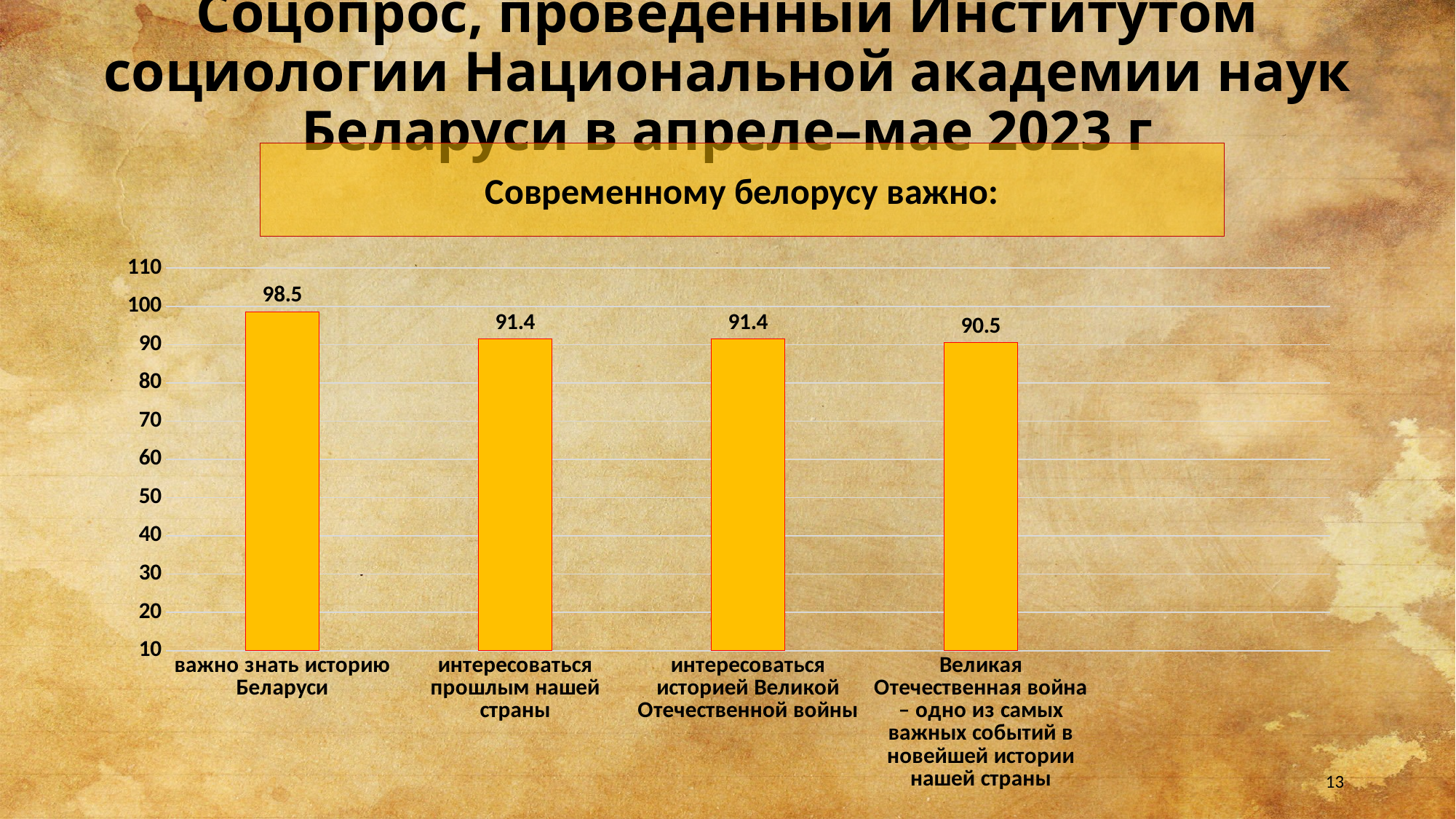
What is the difference between the values for "интересоваться историей Великой Отечественной войны" and "Великая Отечественная война – одно из самых важных событий в новейшей истории нашей страны"? 0.9 Which category has the lowest value? Великая Отечественная война – одно из самых важных событий в новейшей истории нашей страны What is the value for the category "Великая Отечественная война – одно из самых важных событий в новейшей истории нашей страны"? 90.5 What is the value for "интересоваться историей Великой Отечественной войны"? 91.4 What is the value for "важно знать историю Беларуси"? 98.5 Which category has the highest value? важно знать историю Беларуси Which is larger: the value for "важно знать историю Беларуси" or the value for "Великая Отечественная война – одно из самых важных событий в новейшей истории нашей страны"? важно знать историю Беларуси What is the heading shown in the box above the chart? Современному белорусу важно: What kind of chart is shown on the slide? bar chart How many categories are shown in the chart? 4 What is the value for "интересоваться прошлым нашей страны"? 91.4 What is the difference between the values for "важно знать историю Беларуси" and "интересоваться прошлым нашей страны"? 7.1